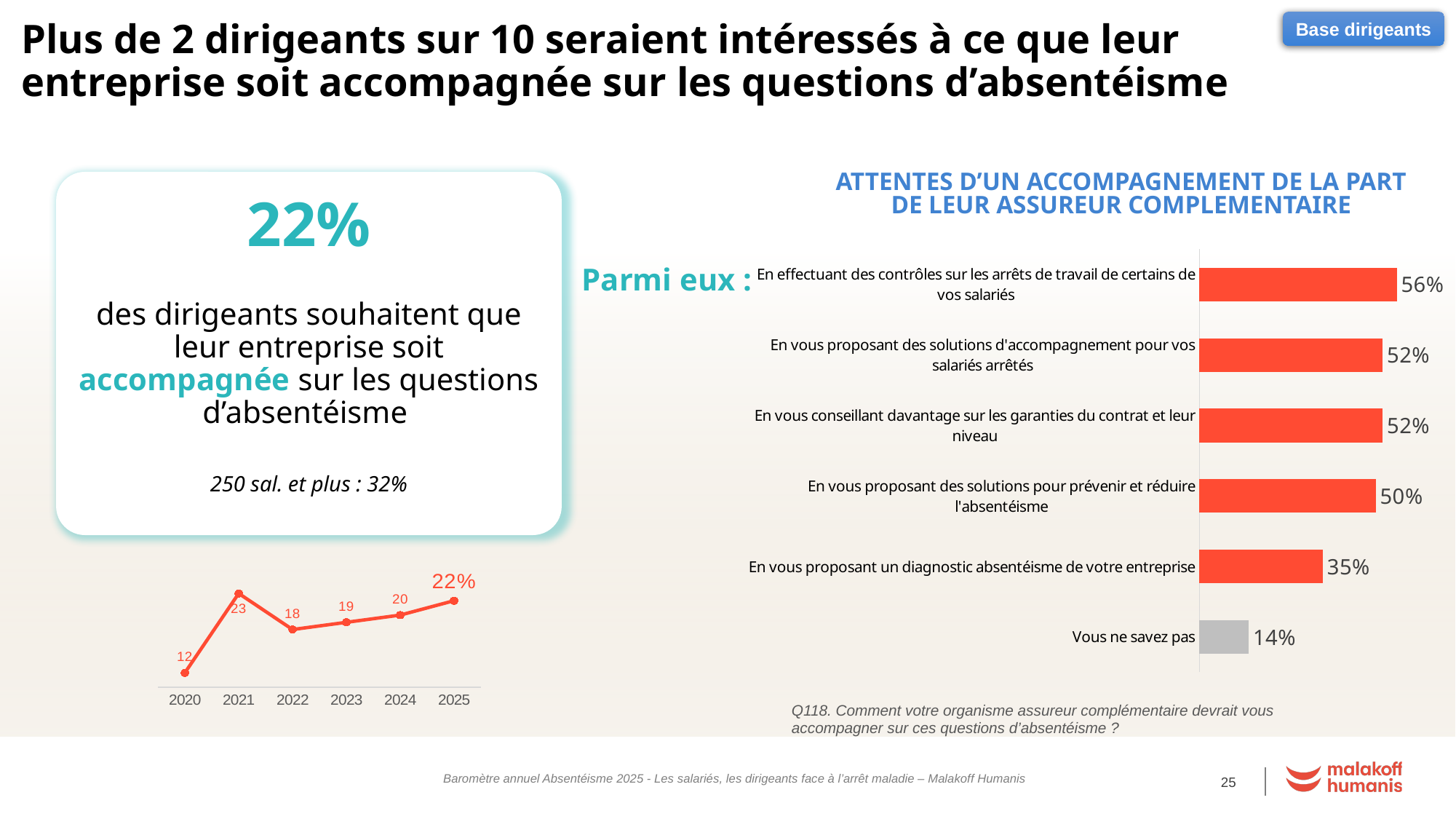
In the bar chart on the right, what is the difference between "En vous proposant des solutions pour prévenir et réduire l'absentéisme" and "Vous ne savez pas"? 36 percentage points In the bar chart on the right, how many categories are shown? 6 In the bar chart on the right, what is the value for "En vous proposant un diagnostic absentéisme de votre entreprise"? 35% In the bar chart on the right, what is the value for "En effectuant des contrôles sur les arrêts de travail de certains de vos salariés"? 56% In the line chart at the bottom left, which year has the highest value? 2021 In the line chart at the bottom left, what is the value for 2020? 12 In the bar chart on the right, which category has the lowest value? Vous ne savez pas In the line chart at the bottom left, what is the value for 2021? 23 In the line chart at the bottom left, do the values rise or fall from 2022 to 2025? Rise In the bar chart on the right, which category has the highest value? En effectuant des contrôles sur les arrêts de travail de certains de vos salariés In the line chart at the bottom left, how many years are plotted? 6 What kind of chart is the chart on the right of the slide? Bar chart